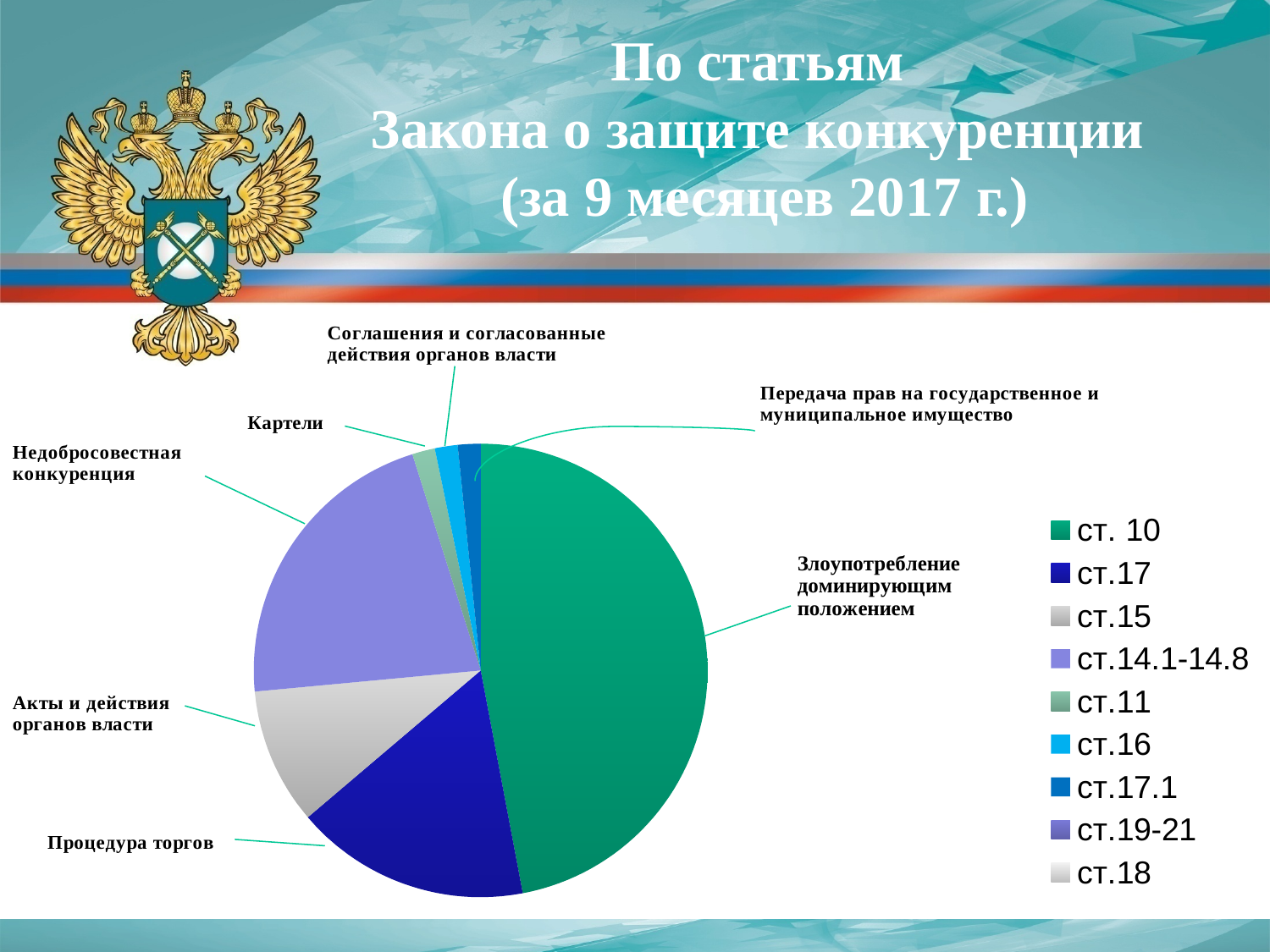
Which slice is larger, ст.17 or ст.15? ст.17 Which slice is larger, ст. 10 or ст.14.1-14.8? ст. 10 Which legend entry corresponds to the largest slice of the pie chart? ст. 10 What period does the chart title say the data covers? за 9 месяцев 2017 г. Which category label is attached to the largest slice of the pie chart? Злоупотребление доминирующим положением What kind of chart is shown on the slide? pie chart Which slice is larger, ст.14.1-14.8 or ст.11? ст.14.1-14.8 What colour is the slice for ст. 10 in the pie chart? green How many entries does the legend of the pie chart list? 9